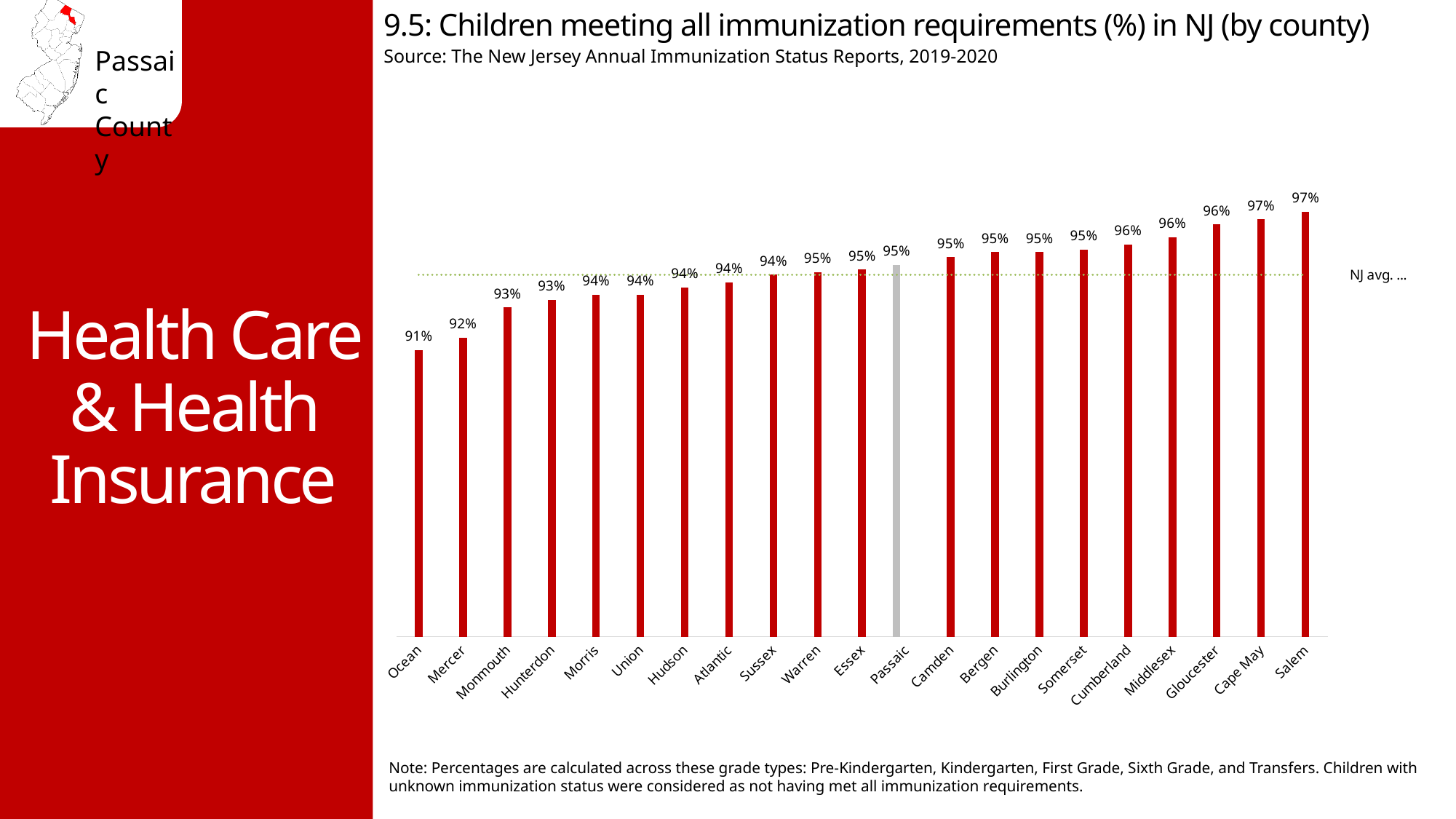
What is the difference in percentage points between Salem and Ocean? 6 percentage points What percentage is shown for Cumberland County? 96% Do the values generally rise or fall from left to right across the counties? Rise Which county's bar is shown in gray instead of red? Passaic How many counties are shown in the chart? 21 What is the value shown for Mercer County? 92% What is the value shown for Passaic County? 95% What percentage of children in Ocean County met all immunization requirements? 91% What is the difference in percentage points between Passaic and Ocean? 4 percentage points Which county has the lowest percentage of children meeting all immunization requirements? Ocean Which has a higher value, Monmouth or Cumberland? Cumberland What kind of chart is used on this slide? Bar chart